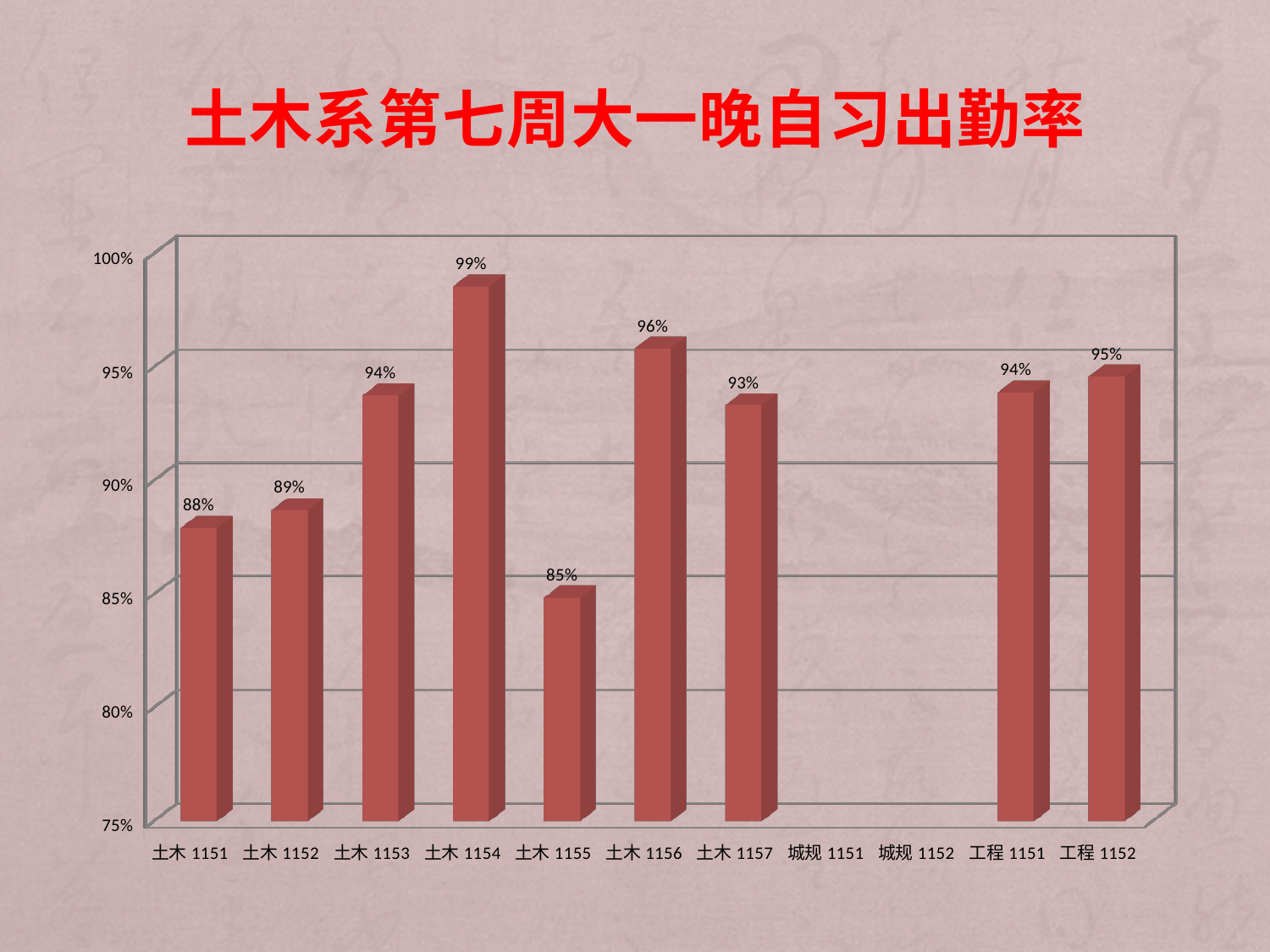
How many class labels are listed along the x axis? 11 Which class has the highest attendance rate in the chart? 土木 1154 Do the values rise or fall from 土木 1151 to 土木 1154? rise Among the bars plotted, which class has the lowest attendance rate? 土木 1155 Is the value for 土木 1155 greater or less than 90%? less What is the attendance rate shown for 土木 1154? 99% What is the title of the chart on the slide? 土木系第七周大一晚自习出勤率 What kind of chart is shown on the slide? bar chart What value is labelled on the bar for 土木 1155? 85% What is the difference between the values for 土木 1154 and 土木 1155? 14 percentage points What is the value shown for 工程 1152? 95% Which is larger, the value for 土木 1156 or the value for 工程 1152? 土木 1156